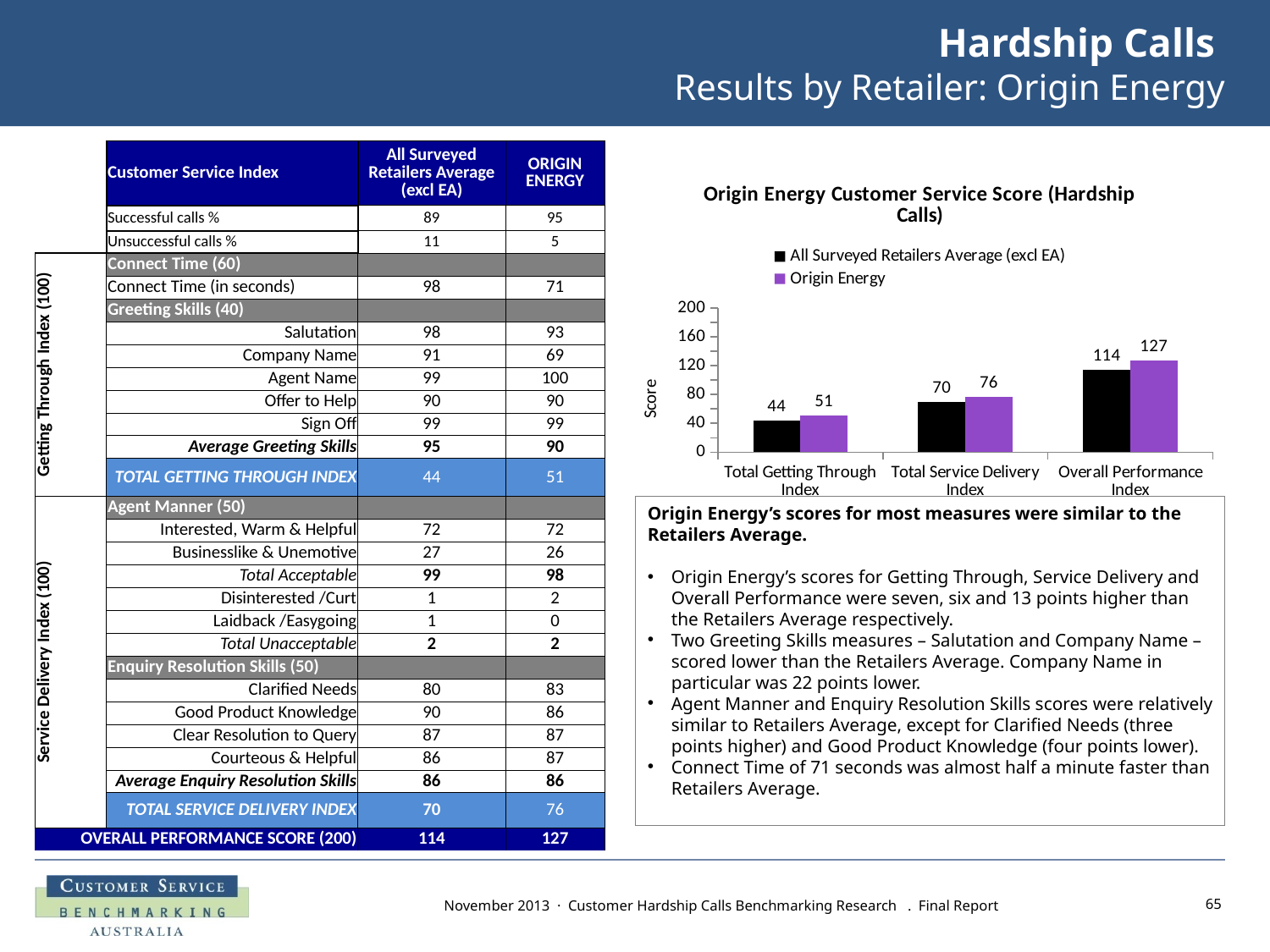
What is the All Surveyed Retailers Average (excl EA) value for Total Service Delivery Index in the chart? 70 What kind of chart is shown on the slide? bar chart What is the title of the chart? Origin Energy Customer Service Score (Hardship Calls) What is the Origin Energy value for Total Getting Through Index in the chart? 51 Which category has the lowest All Surveyed Retailers Average (excl EA) value in the chart? Total Getting Through Index How many series does the chart legend list? 2 Which is larger for Total Service Delivery Index: the Origin Energy value or the All Surveyed Retailers Average (excl EA) value? Origin Energy Which category has the highest Origin Energy value in the chart? Overall Performance Index Is the All Surveyed Retailers Average (excl EA) value for Overall Performance Index greater or less than 80? greater How many categories are shown on the x axis of the chart? 3 What is the Origin Energy value for Overall Performance Index in the chart? 127 What is the difference between the Origin Energy and All Surveyed Retailers Average (excl EA) values for Overall Performance Index? 13